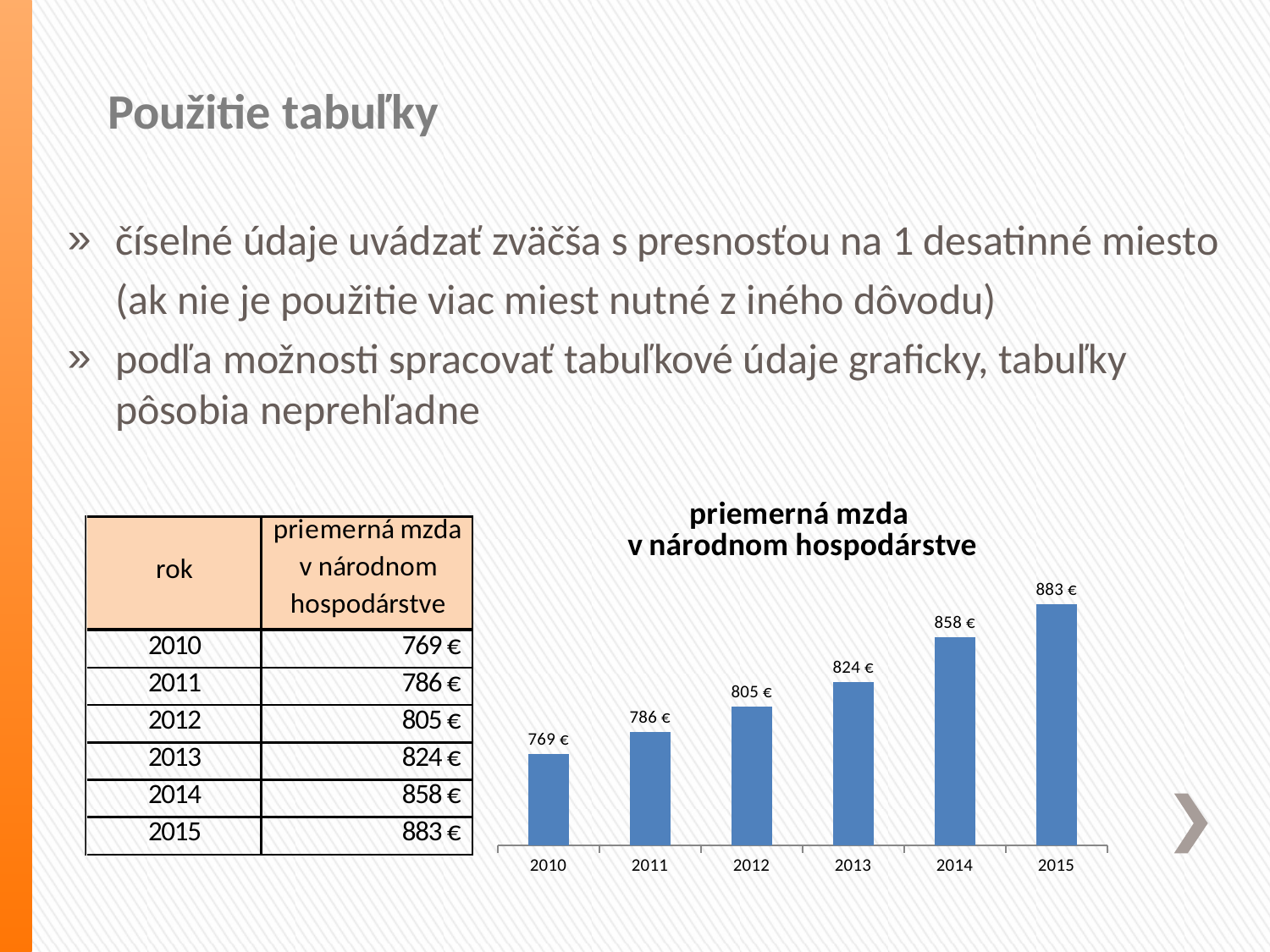
Which is larger, the value for 2011 or the value for 2013? 2013 Do the values rise or fall from 2010 to 2015? rise How many years are shown on the x axis of the chart? 6 What is the difference between the values for 2015 and 2010? 114 € Which year has the highest value in the chart? 2015 What is the title of the chart? priemerná mzda v národnom hospodárstve What is the difference between the values for 2013 and 2012? 19 € What is the value for 2014 in the chart? 858 € What colour are the bars in the chart? blue What kind of chart is shown on the slide? bar chart What is the value for 2012 in the chart? 805 € Which year has the lowest value in the chart? 2010